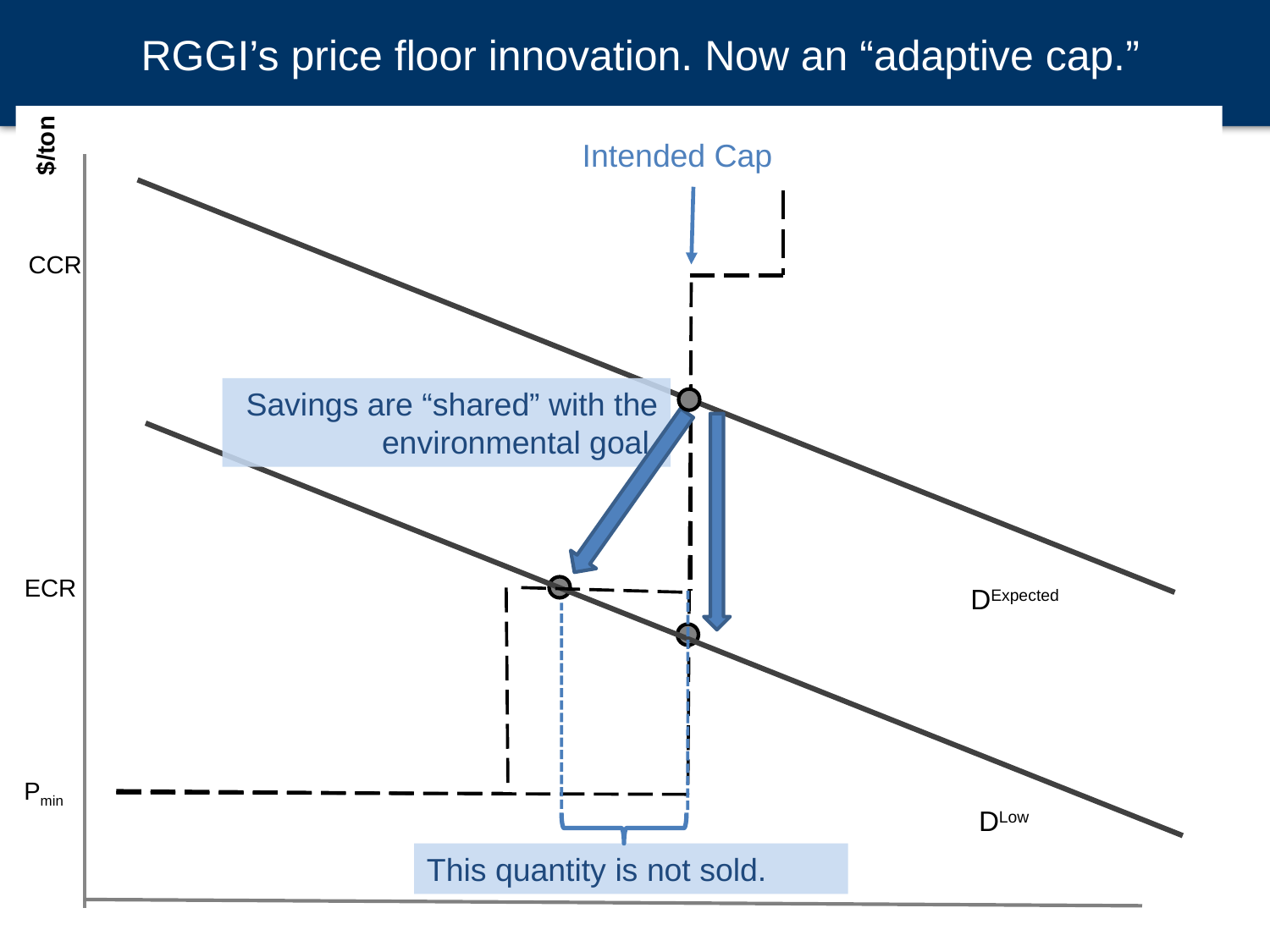
Which of the three price levels marked on the vertical axis (CCR, ECR, Pmin) is the highest? CCR What label is given to the vertical dashed line marked with a downward arrow at the top of the diagram? Intended Cap Which of the three price levels marked on the vertical axis (CCR, ECR, Pmin) is the lowest? Pmin Which demand curve lies higher on the diagram, D Expected or D Low? D Expected What is the label on the vertical axis of the diagram? $/ton What is the title of the slide containing the diagram? RGGI's price floor innovation. Now an "adaptive cap." Is the ECR price level above or below the CCR price level? below Do the demand curves rise or fall as you move to the right along the horizontal axis? fall How many demand curves are drawn on the diagram? 2 How many marked points (circles) are shown on the demand curves? 3